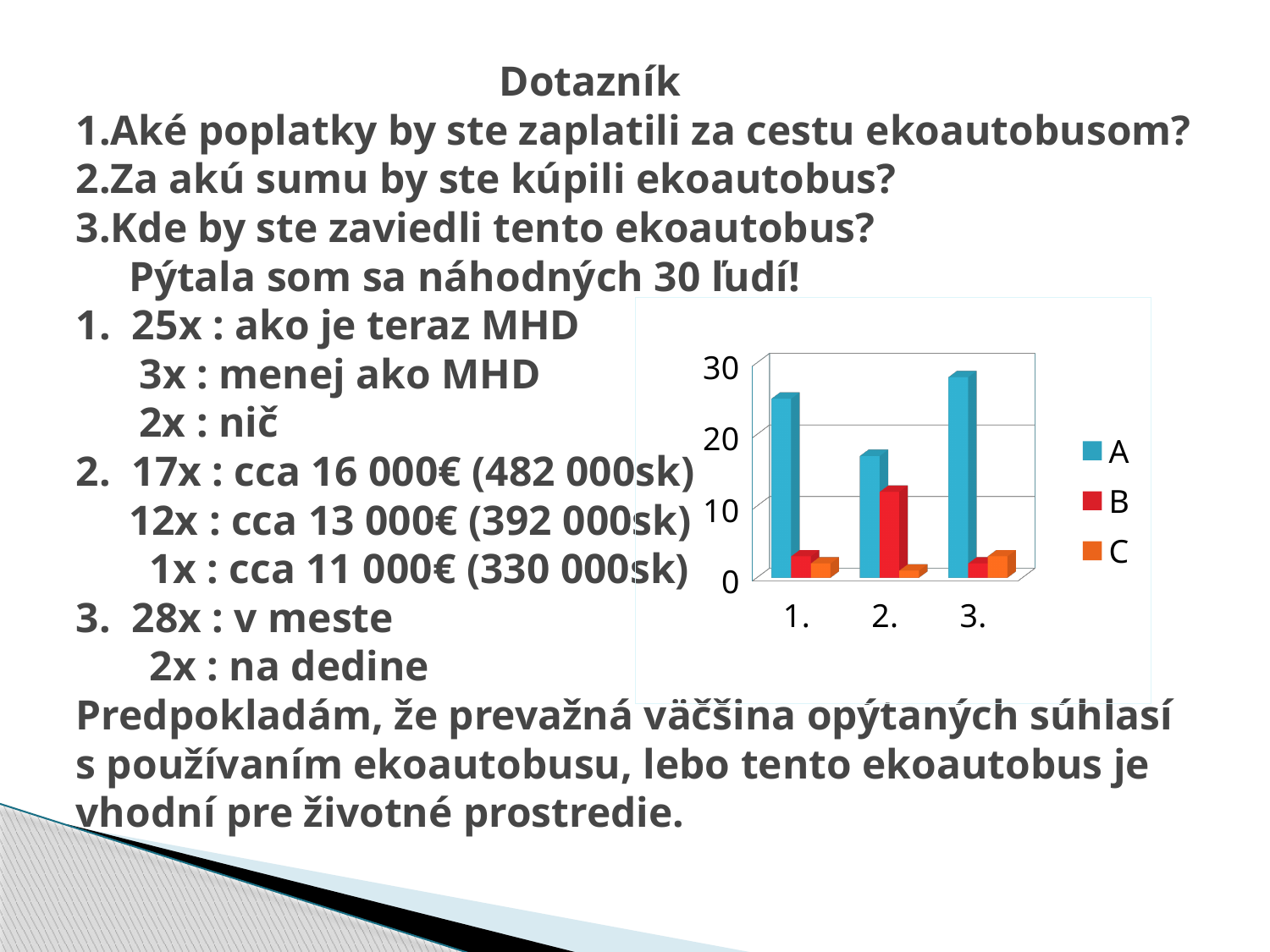
In category 2., which is larger, series A or series B? A What kind of chart is shown on the slide? bar chart Is the value for series A in category 1. greater or less than 20? greater Is the value for series B in category 1. greater or less than 10? less Which category has the tallest bar for series A? 3. Is the value for series A in category 2. greater or less than 20? less Which category has the shortest bar for series A? 2. Which category has the tallest bar for series B? 2. How many series does the chart's legend list? 3 How many categories are shown on the x axis of the chart? 3 What are the legend entries of the chart? A, B, C